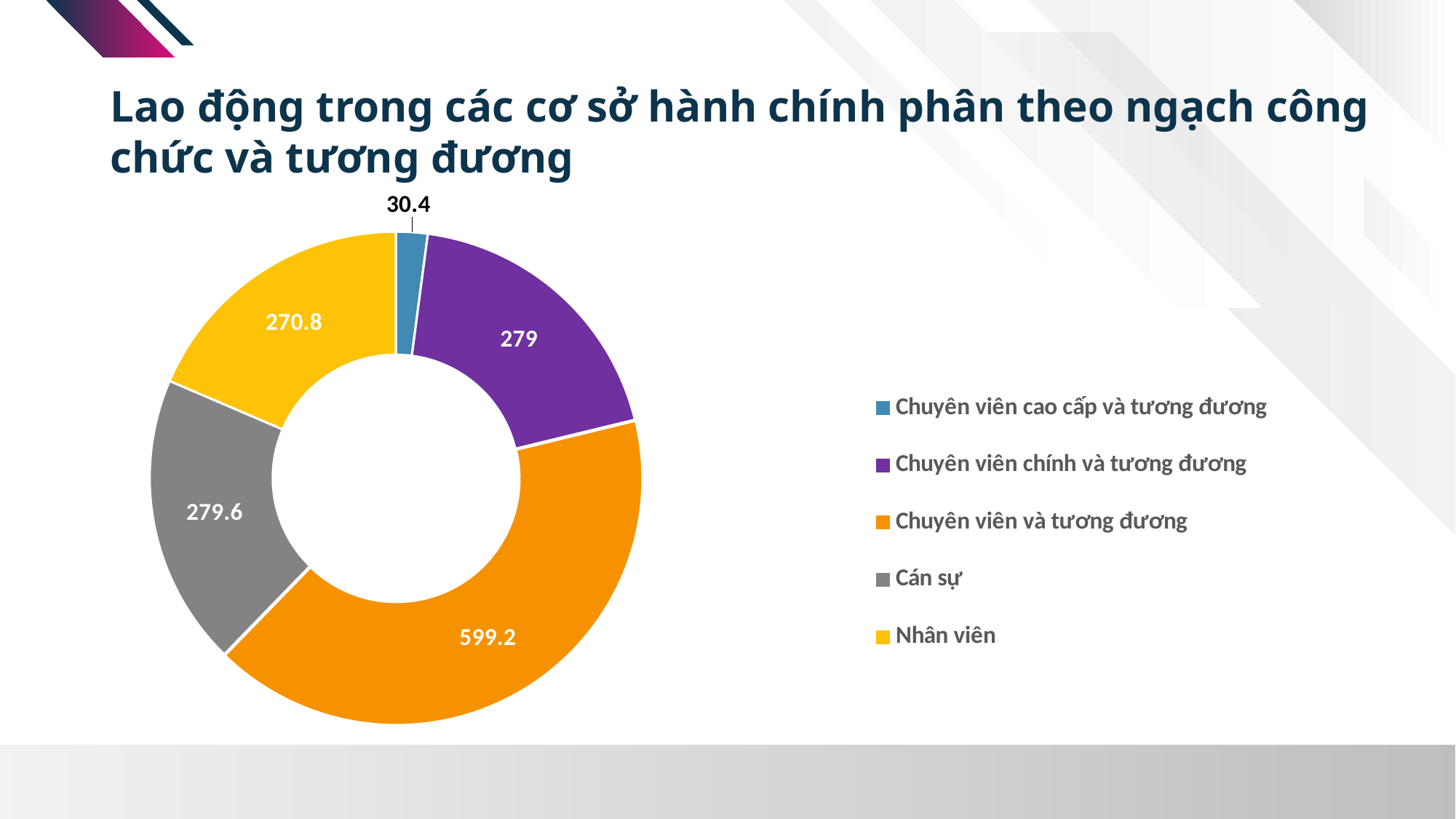
Which category has the lowest value? Chuyên viên cao cấp và tương đương What is the difference between the values for Chuyên viên và tương đương and Cán sự? 319.6 What is the value for Chuyên viên cao cấp và tương đương? 30.4 What colour is the segment for Cán sự? Gray What is the value for Nhân viên? 270.8 What kind of chart is shown on the slide? Doughnut chart Which is larger, the value for Chuyên viên và tương đương or the value for Nhân viên? Chuyên viên và tương đương What is the value for Chuyên viên và tương đương? 599.2 What is the difference between the values for Chuyên viên chính và tương đương and Chuyên viên cao cấp và tương đương? 248.6 Which category has the highest value? Chuyên viên và tương đương How many categories does the chart show? 5 What is the value for Cán sự? 279.6